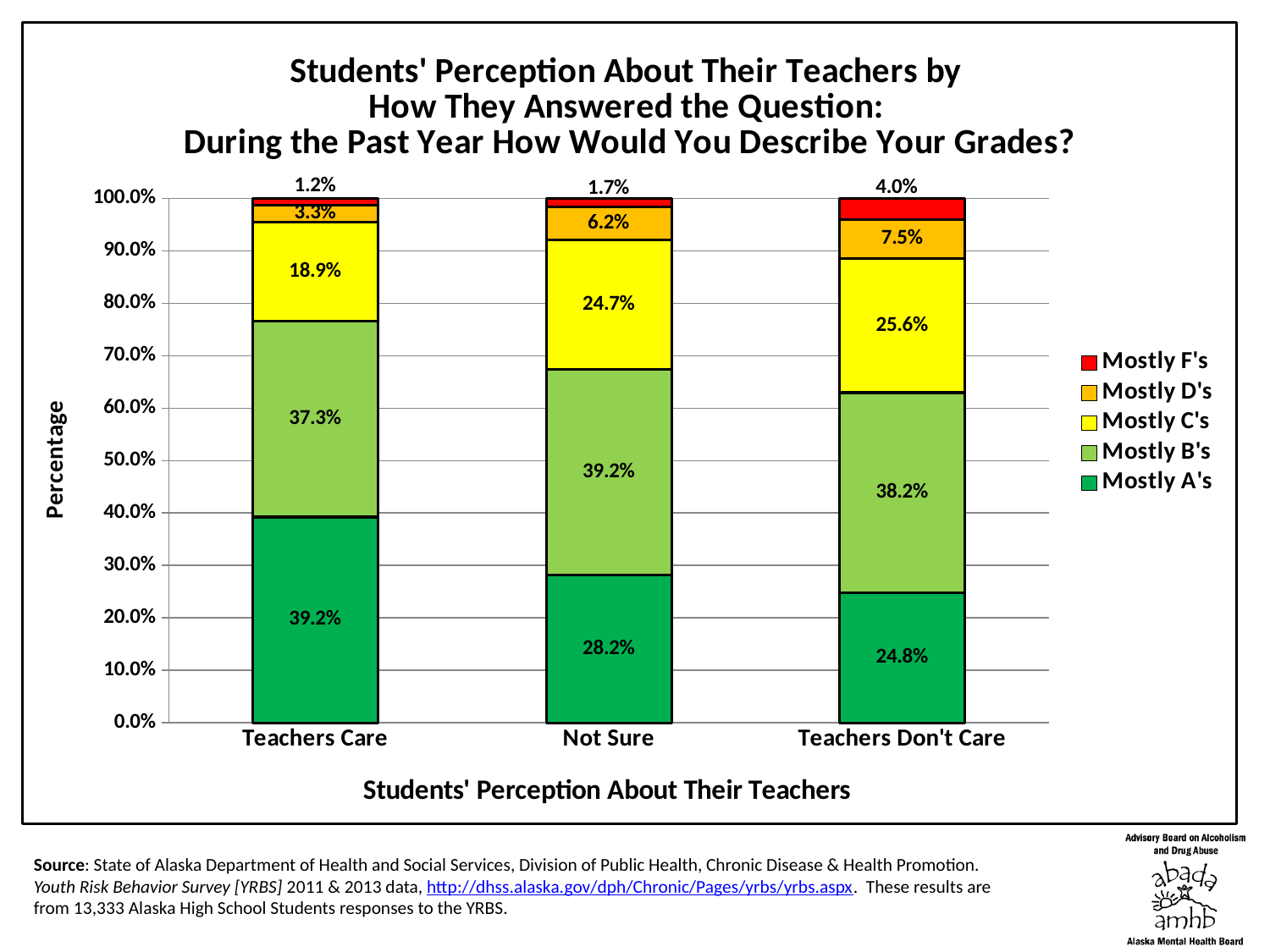
Which has a larger Mostly B's percentage, "Not Sure" or "Teachers Don't Care"? Not Sure What percentage of students who answered "Teachers Don't Care" reported Mostly F's? 4.0% What kind of chart is shown on the slide? Stacked bar chart Which perception category has the highest percentage of Mostly A's? Teachers Care What percentage of students who answered "Teachers Care" reported Mostly A's? 39.2% Which perception category has the lowest percentage of Mostly C's? Teachers Care What is the title of the y axis? Percentage How many perception categories are shown on the x axis? 3 What is the Mostly D's value for the "Not Sure" category? 6.2% How many series does the legend list? 5 What is the difference in the Mostly A's percentage between "Teachers Care" and "Teachers Don't Care"? 14.4% Does the Mostly A's percentage rise or fall moving from "Teachers Care" to "Teachers Don't Care" along the x axis? Fall